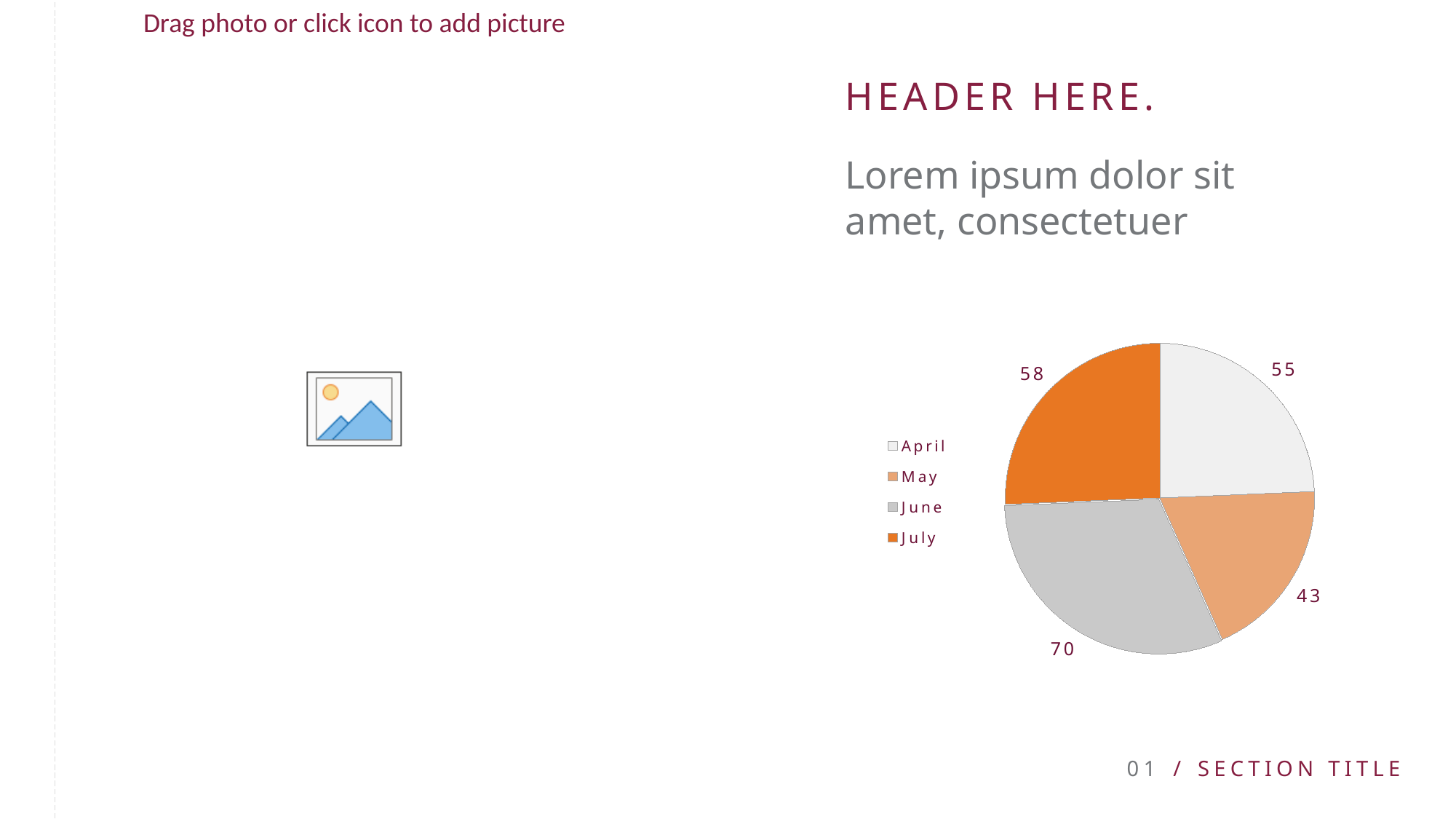
Which month is shown in dark orange in the pie chart? July Which month has the smallest slice in the pie chart? May Which is larger, the value for July or the value for April? July What type of chart is shown on the slide? pie chart What is the value for May in the pie chart? 43 Which month has the largest slice in the pie chart? June What is the value for April in the pie chart? 55 What is the value for July in the pie chart? 58 How many slices does the pie chart have? 4 What is the difference between the values for June and May? 27 What is the value for June in the pie chart? 70 What is the total of all the values in the pie chart? 226